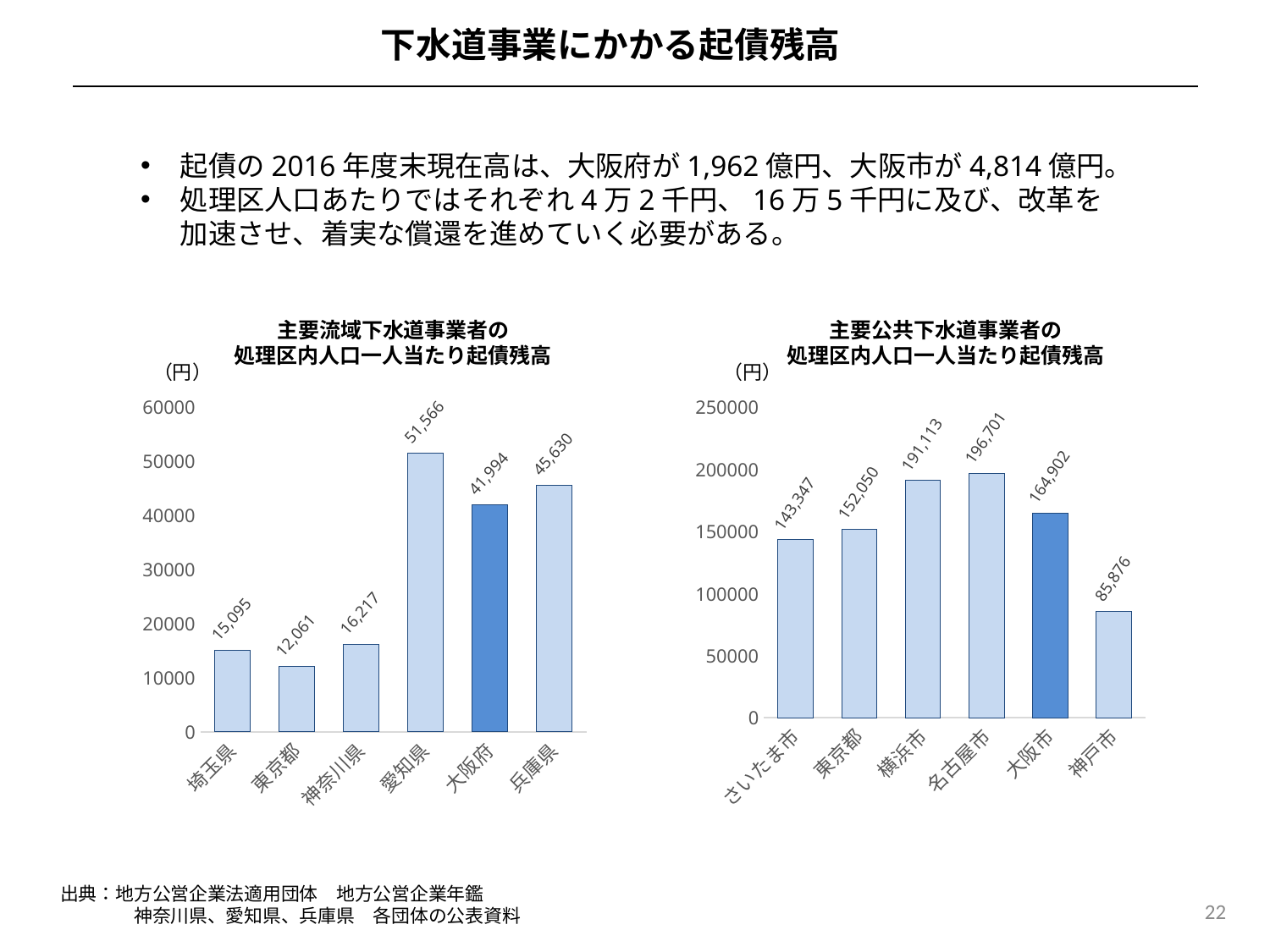
In the left chart, which prefecture has the highest value? 愛知県 In the left chart, what is the difference between the values for 愛知県 and 大阪府? 9,572 In the left chart, which bar is shown in a darker blue than the others? 大阪府 In the right chart (主要公共下水道事業者の処理区内人口一人当たり起債残高), what is the value for 大阪市? 164,902 In the right chart, which is larger, the value for 横浜市 or the value for 大阪市? 横浜市 In the right chart, what is the difference between the values for 名古屋市 and 神戸市? 110,825 In the left chart, which prefecture has the lowest value? 東京都 What type of chart is the right chart? Bar chart In the right chart, which city has the highest value? 名古屋市 In the right chart, which city has the lowest value? 神戸市 In the left chart (主要流域下水道事業者の処理区内人口一人当たり起債残高), what is the value for 大阪府? 41,994 In the left chart, how many prefectures are shown? 6